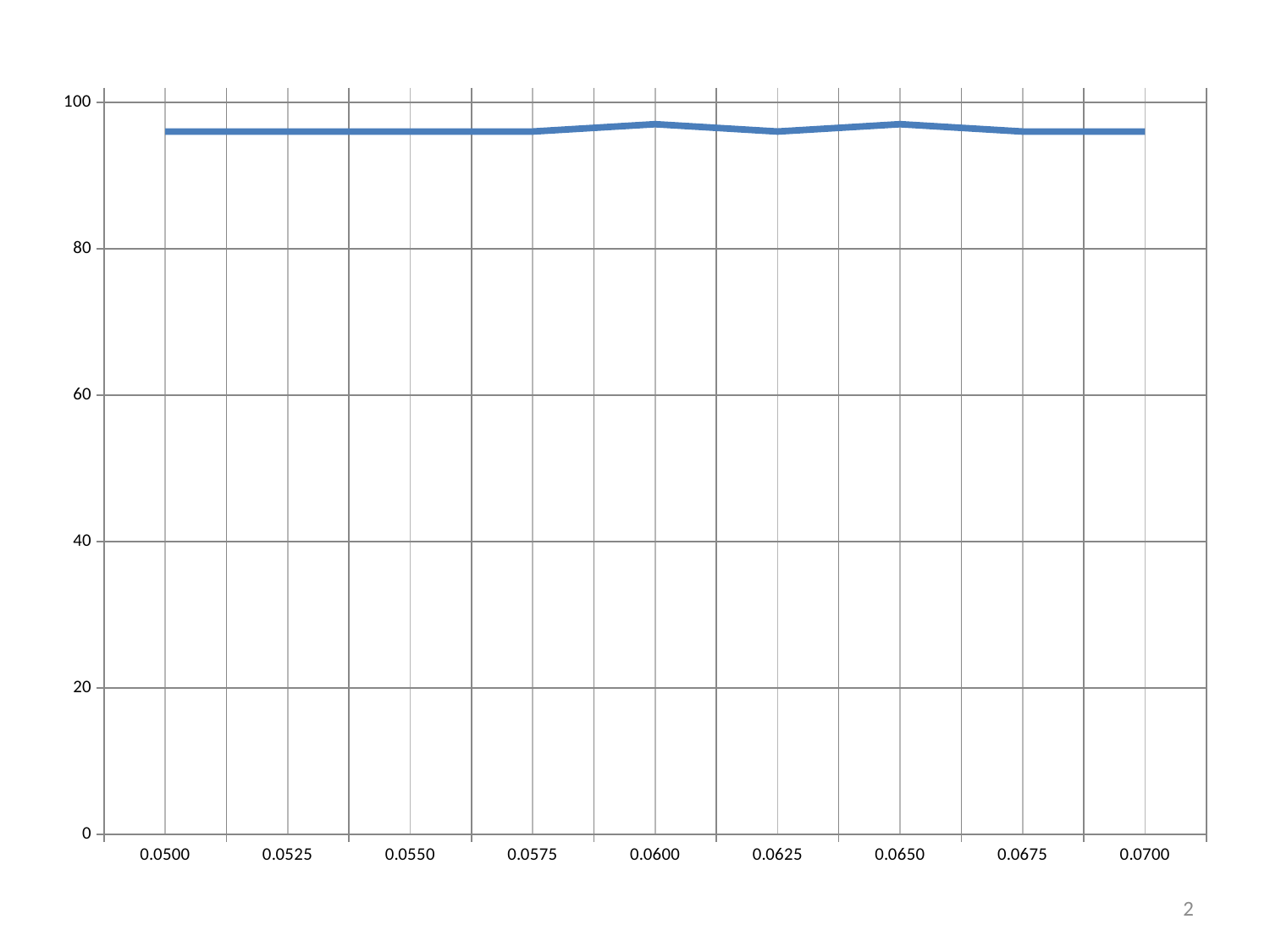
What kind of chart is shown on the slide? line chart Is the value at 0.0700 greater or less than 100? less What is the highest tick value shown on the y axis? 100 Is the value at 0.0500 greater or less than 80? greater How many labeled points are there along the x axis? 9 How many lines are plotted on the chart? 1 Is the value at 0.0600 greater or less than 60? greater Do the values rise, fall, or stay roughly flat as the x axis goes from 0.0500 to 0.0700? stay roughly flat What is the first label on the x axis? 0.0500